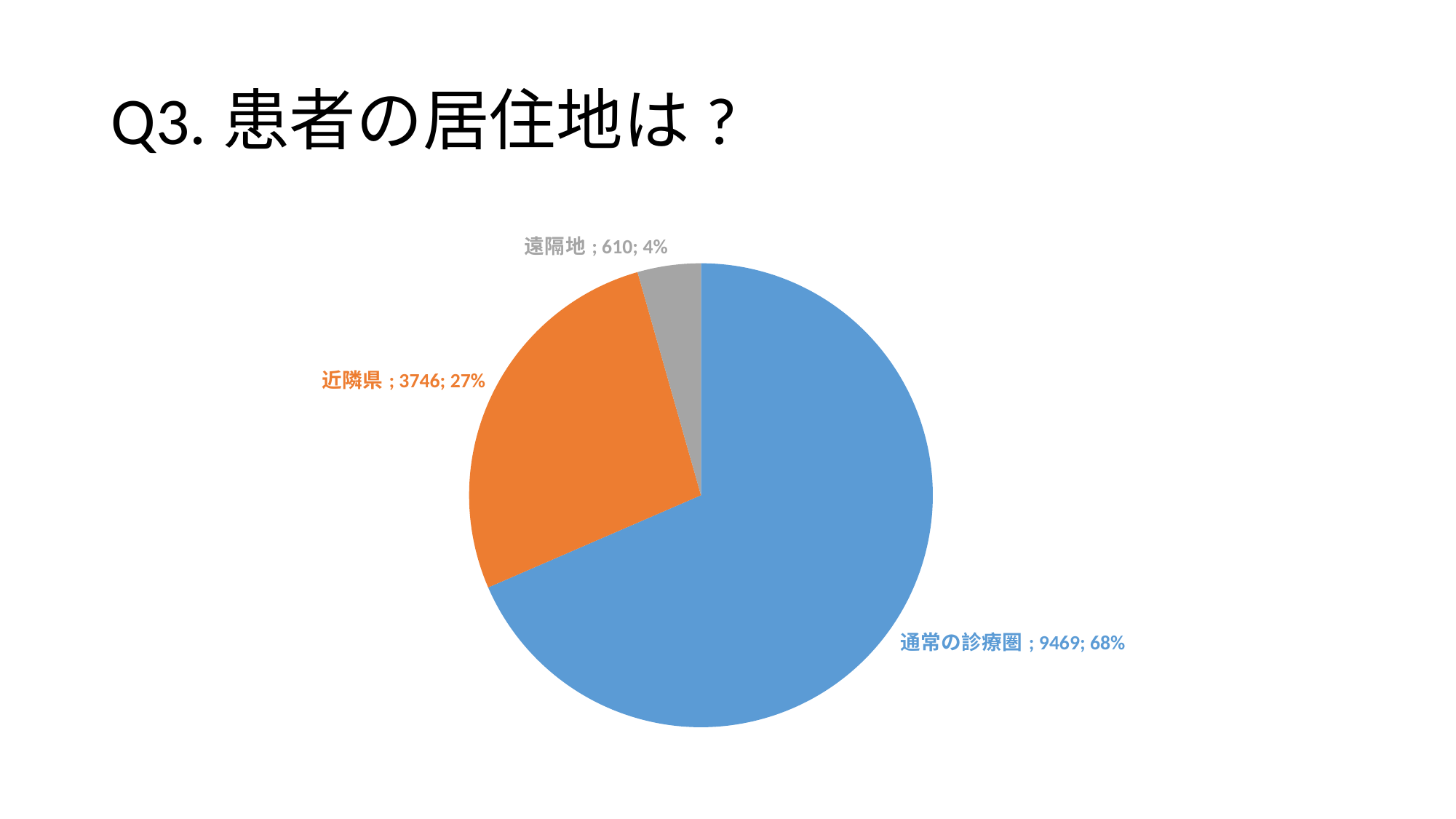
What is the value for 近隣県? 3746 What is the value for 遠隔地? 610 What is the value for 通常の診療圏? 9469 What colour is the slice for 近隣県? orange What share of the pie does 遠隔地 represent? 4% Which is larger, the value for 近隣県 or the value for 遠隔地? 近隣県 Which category has the largest slice? 通常の診療圏 Which category has the smallest slice? 遠隔地 How many slices does the pie chart have? 3 What is the difference between the values for 通常の診療圏 and 近隣県? 5723 What share of the pie does 近隣県 represent? 27% What kind of chart is shown on the slide? pie chart